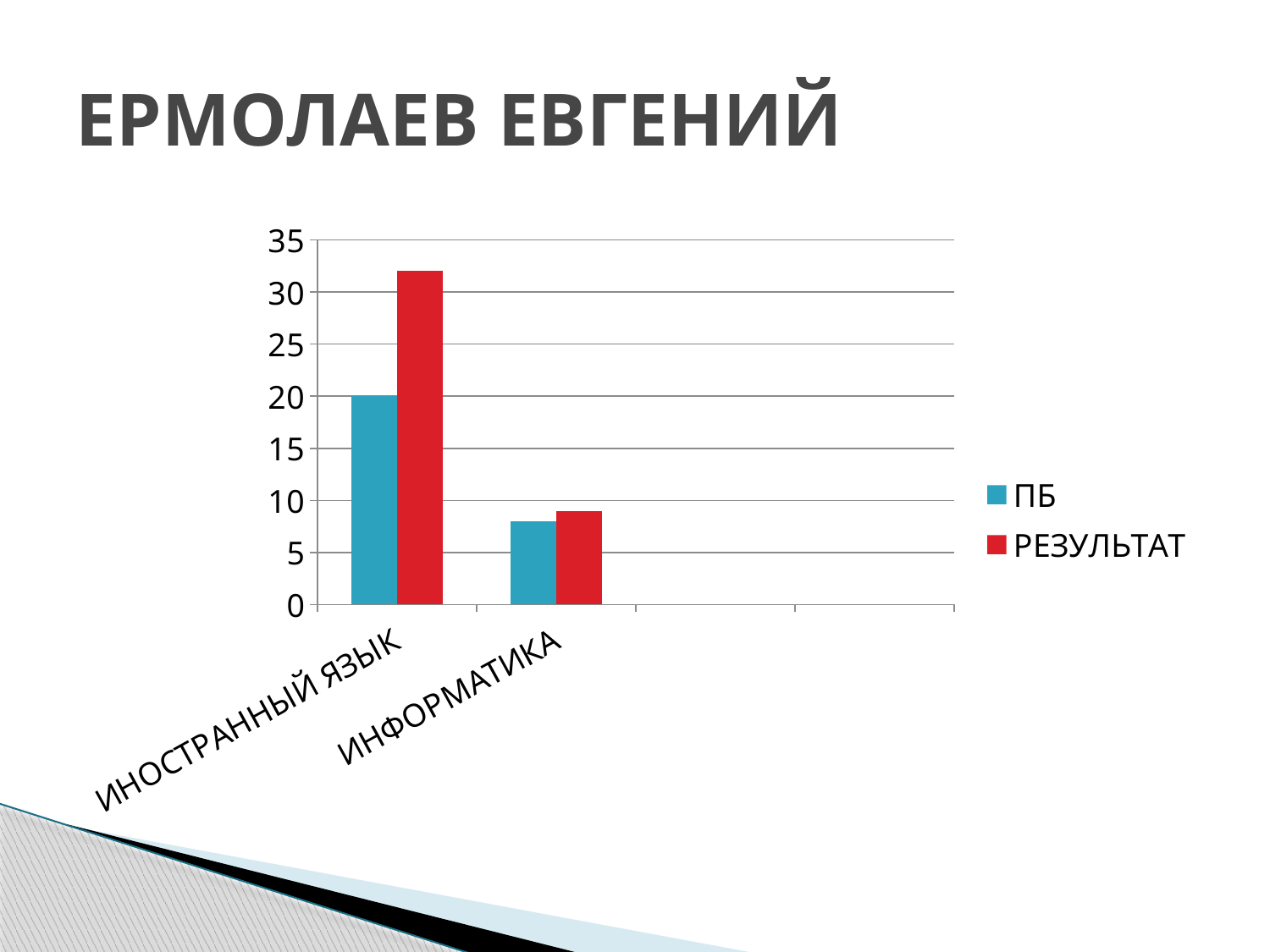
What is the value of ПБ for ИНОСТРАННЫЙ ЯЗЫК? 20 Is the value of РЕЗУЛЬТАТ for ИНОСТРАННЫЙ ЯЗЫК greater or less than 30? greater Is the value of РЕЗУЛЬТАТ for ИНФОРМАТИКА greater or less than 10? less What type of chart is shown on the slide? bar chart How many categories are shown on the x axis of the chart? 2 Which category has the lowest ПБ value? ИНФОРМАТИКА Which series is shown in red in the chart? РЕЗУЛЬТАТ Which category has the highest РЕЗУЛЬТАТ value? ИНОСТРАННЫЙ ЯЗЫК What are the two series listed in the chart's legend? ПБ and РЕЗУЛЬТАТ Is the value of ПБ for ИНФОРМАТИКА greater or less than 10? less Which is larger: the ПБ value for ИНОСТРАННЫЙ ЯЗЫК or the ПБ value for ИНФОРМАТИКА? ИНОСТРАННЫЙ ЯЗЫК How many series does the chart's legend list? 2